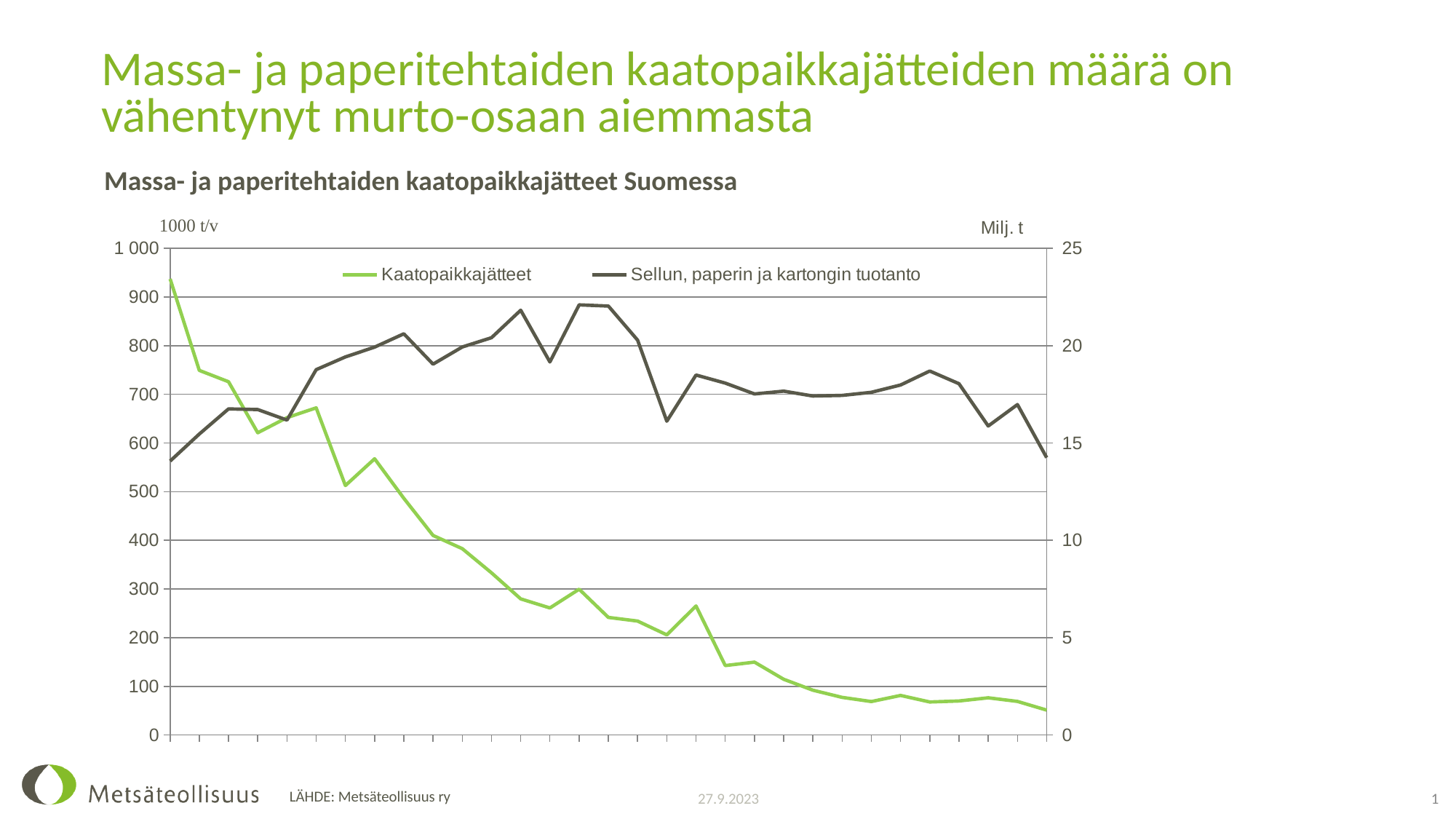
Is the last (rightmost) value of the Sellun, paperin ja kartongin tuotanto series greater or less than 15 on the right axis? less Is the first (leftmost) value of the Sellun, paperin ja kartongin tuotanto series greater or less than 15 on the right axis? less What kind of chart is shown on the slide? line chart Is the highest value of the Sellun, paperin ja kartongin tuotanto series greater or less than 20 on the right axis? greater Does the Kaatopaikkajätteet series rise or fall overall from left to right along the x axis? fall What unit label is shown on the right-hand axis of the chart? Milj. t What is the title of the chart? Massa- ja paperitehtaiden kaatopaikkajätteet Suomessa How many series does the chart legend list? 2